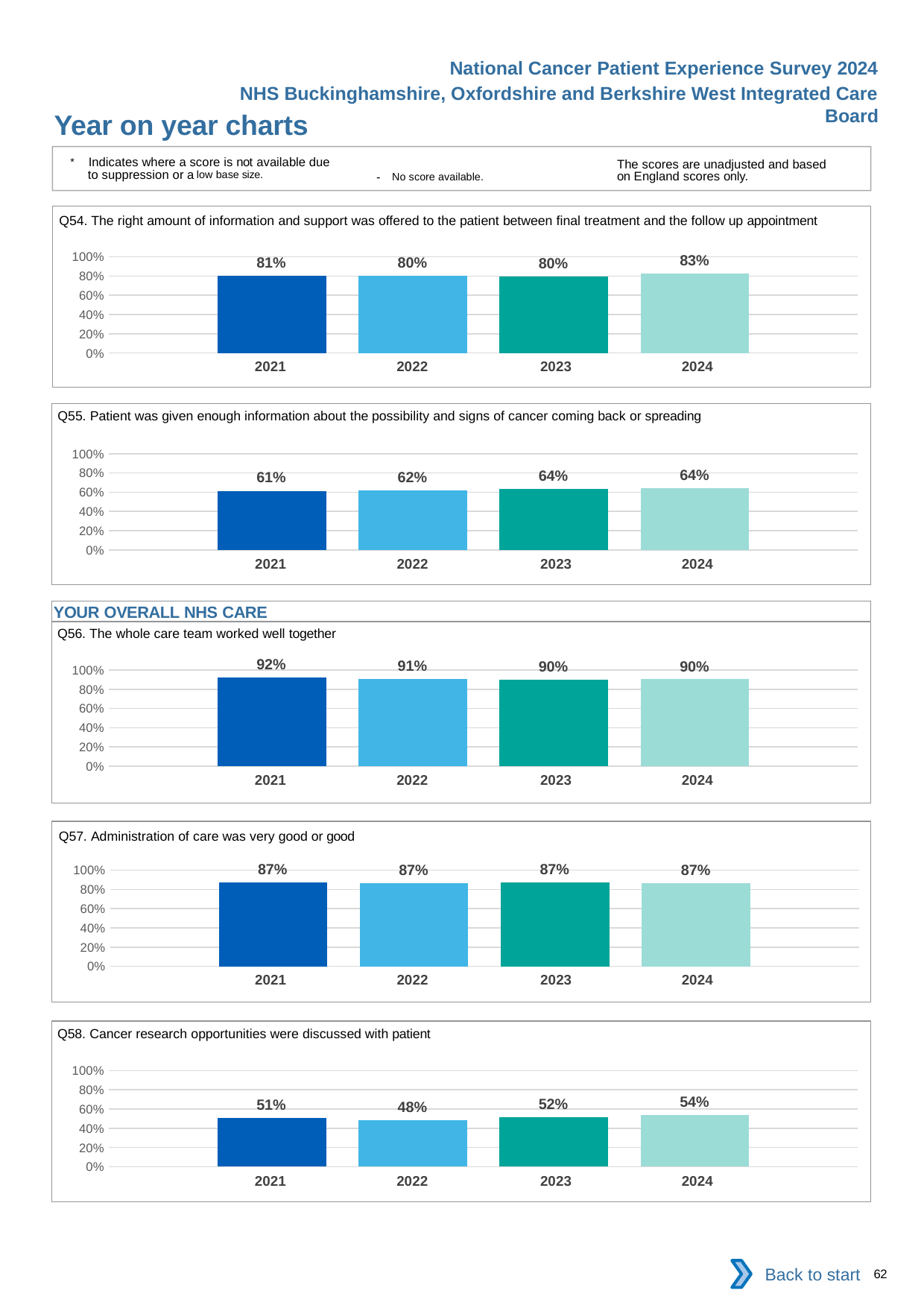
In the Q54 chart, what is the value for 2024? 83% In the Q58 chart, which is larger, the value for 2021 or the value for 2024? 2024 What kind of chart is the Q54 chart? bar chart In the Q55 chart, what is the difference between the 2024 value and the 2021 value? 3 percentage points In the Q56 chart, do the values rise or fall from 2021 to 2024? fall In the Q58 chart, which year has the lowest value? 2022 In the Q58 chart, is the value for 2022 greater or less than 60%? less In the Q54 chart, which year has the highest value? 2024 In the Q55 chart, what is the value for 2021? 61% In the Q56 chart, which year has the highest value? 2021 In the Q57 chart, what is the value for 2023? 87% How many years are shown on the x axis of the Q57 chart? 4